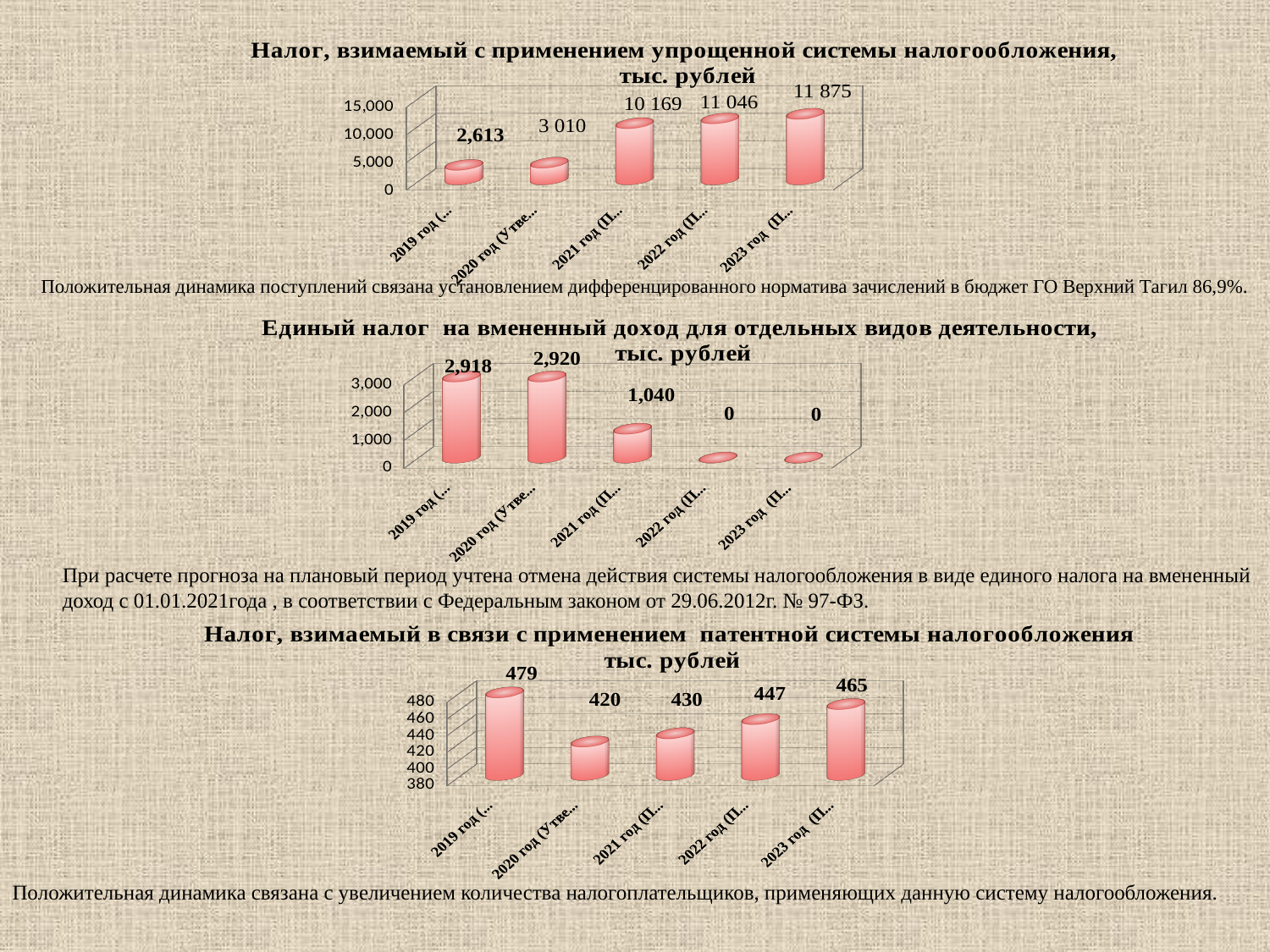
In the bottom chart (патентной системы налогообложения), what is the difference between the values for 2019 год and 2020 год? 59 In the top chart (упрощенной системы налогообложения), which year has the highest value? 2023 год In the bottom chart (патентной системы налогообложения), what is the value for 2022 год? 447 In the top chart (упрощенной системы налогообложения), what is the difference between the values for 2023 год and 2021 год? 1 706 What kind of chart is the bottom chart (патентной системы налогообложения)? bar chart In the middle chart (Единый налог на вмененный доход), what is the value for 2022 год? 0 In the top chart (Налог, взимаемый с применением упрощенной системы налогообложения), what is the value for 2023 год? 11 875 In the bottom chart (патентной системы налогообложения), which year has the lowest value? 2020 год In the top chart (упрощенной системы налогообложения), what is the value for 2019 год? 2,613 In the top chart (упрощенной системы налогообложения), do the values rise or fall from 2019 to 2023? rise In the middle chart (Единый налог на вмененный доход), what is the value for 2021 год? 1,040 In the middle chart (Единый налог на вмененный доход), how many year categories are plotted? 5